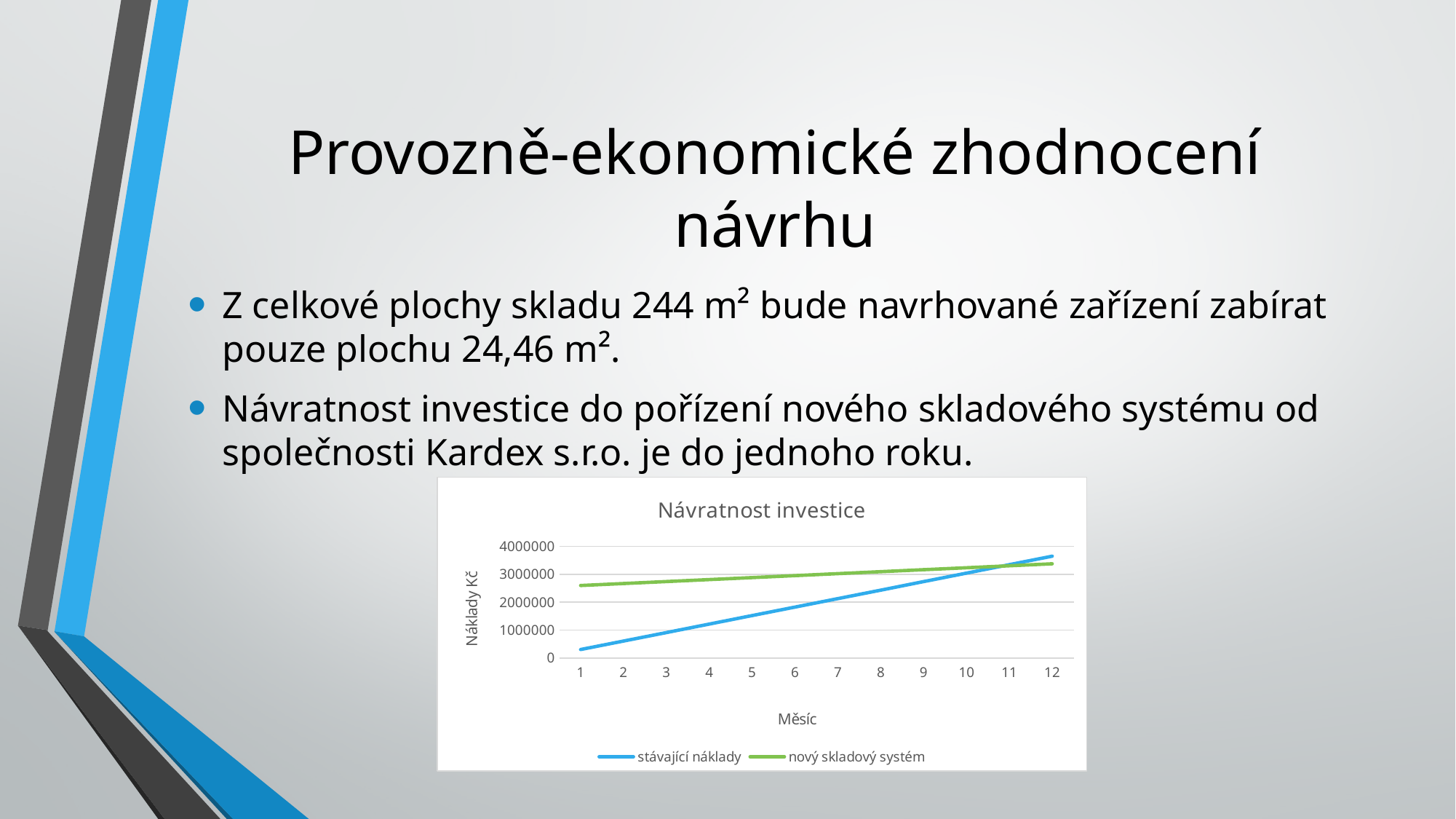
How many months are shown on the x axis of the chart? 12 Is the value for 'stávající náklady' in month 1 greater or less than 1000000? less In month 1, which series has the higher value: 'stávající náklady' or 'nový skladový systém'? nový skladový systém Is the value for 'stávající náklady' in month 12 greater or less than 3000000? greater Does the 'stávající náklady' line rise or fall from month 1 to month 12? rise How many series does the legend of the chart list? 2 In month 6, which series has the higher value: 'stávající náklady' or 'nový skladový systém'? nový skladový systém Is the value for 'nový skladový systém' in month 1 greater or less than 2000000? greater What is the label of the y axis of the chart? Náklady Kč What kind of chart is shown on the slide? line chart What is the title of the chart? Návratnost investice